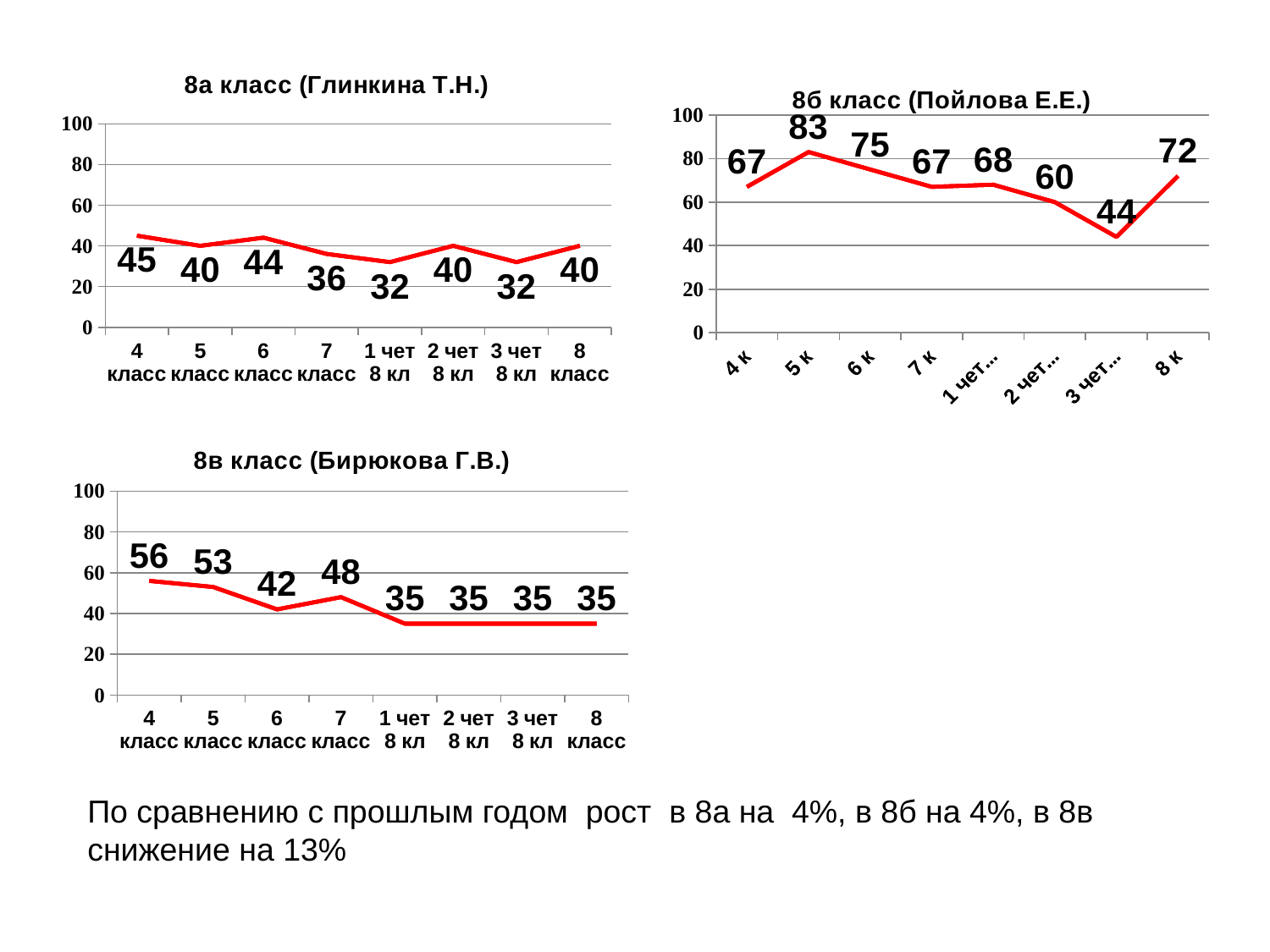
What type of chart is the one titled "8в класс (Бирюкова Г.В.)"? Line chart In the chart titled "8б класс (Пойлова Е.Е.)", which category has the lowest value? 3 чет... In the chart titled "8в класс (Бирюкова Г.В.)", what is the value for "8 класс"? 35 How many charts are shown on the slide? 3 In the chart titled "8в класс (Бирюкова Г.В.)", how many data points are plotted? 8 In the chart titled "8а класс (Глинкина Т.Н.)", what is the value for "7 класс"? 36 In the chart titled "8б класс (Пойлова Е.Е.)", what is the value for "5 к"? 83 In the chart titled "8в класс (Бирюкова Г.В.)", what is the value for "4 класс"? 56 In the chart titled "8а класс (Глинкина Т.Н.)", what is the difference between the values for "4 класс" and "8 класс"? 5 In the chart titled "8б класс (Пойлова Е.Е.)", which is larger, the value for "6 к" or the value for "8 к"? 6 к In the chart titled "8а класс (Глинкина Т.Н.)", which category has the highest value? 4 класс In the chart titled "8б класс (Пойлова Е.Е.)", what is the difference between the values for "8 к" and "3 чет..."? 28